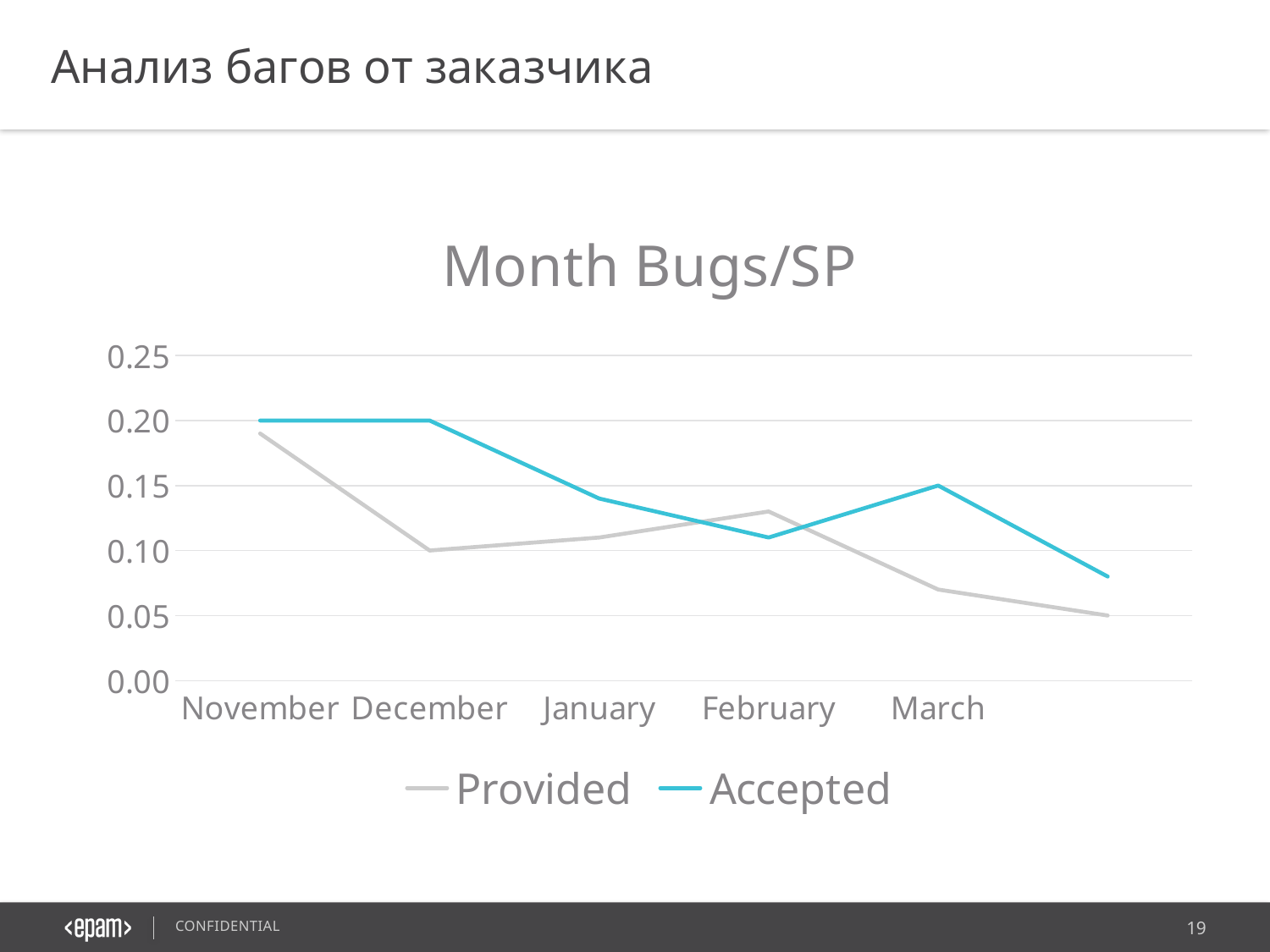
What is the Accepted value for November? 0.20 What is the title of the chart? Month Bugs/SP How many series does the legend list? 2 What type of chart is shown on the slide? line chart Does the Provided series generally rise or fall from November to March? fall What is the Accepted value for December? 0.20 Is the Provided value for March greater or less than 0.10? less In December, which series has the higher value, Provided or Accepted? Accepted What is the Provided value for December? 0.10 What is the Accepted value for March? 0.15 Is the Provided value for November greater or less than 0.15? greater How many month labels appear on the x axis? 5